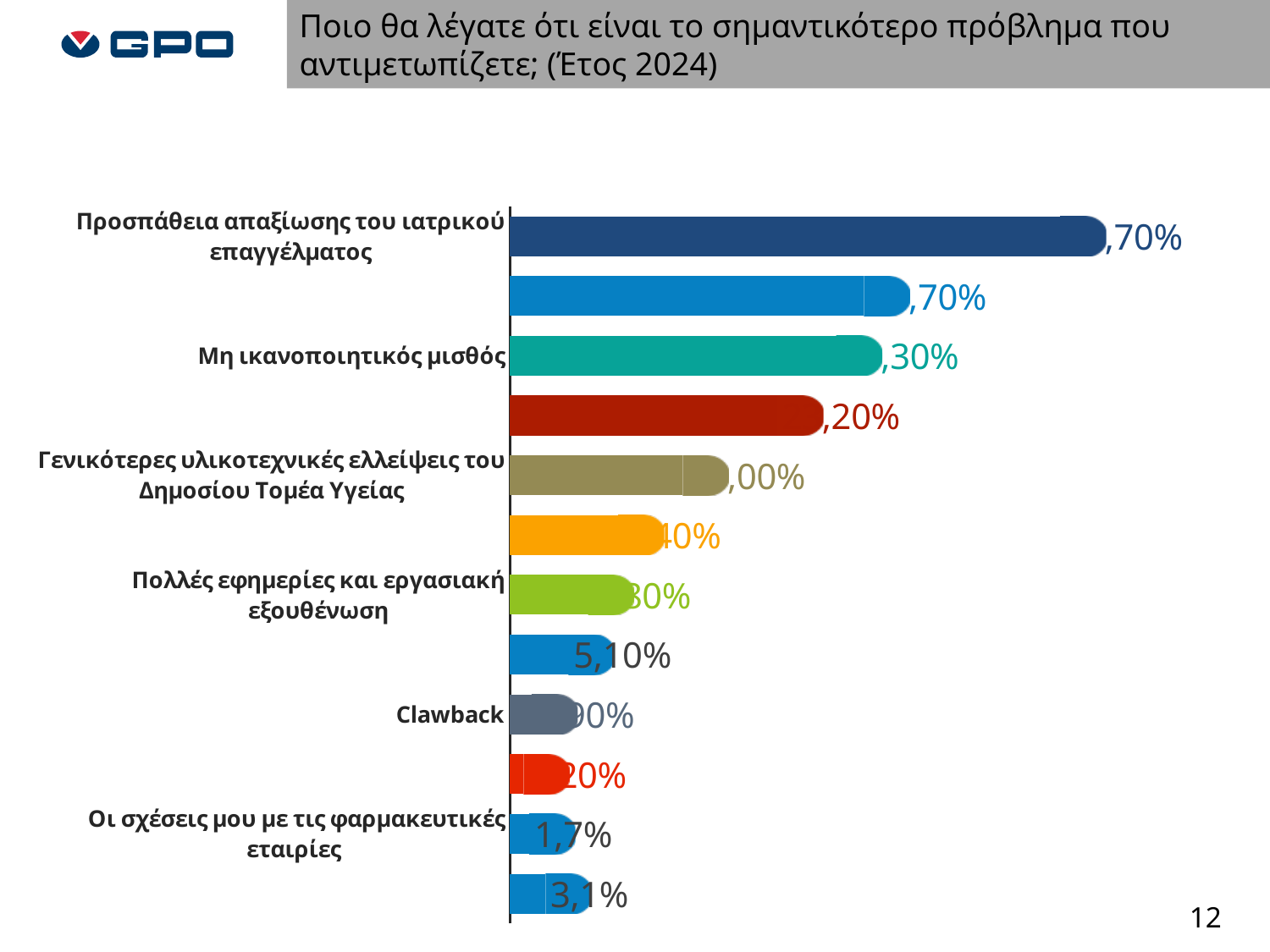
Which is larger, the value for 'Μη ικανοποιητικός μισθός' or the value for 'Clawback'? Μη ικανοποιητικός μισθός How many bars does the chart contain? 12 What type of chart is shown on the slide? Bar chart Which is larger, the value for 'Γενικότερες υλικοτεχνικές ελλείψεις του Δημοσίου Τομέα Υγείας' or the value for 'Πολλές εφημερίες και εργασιακή εξουθένωση'? Γενικότερες υλικοτεχνικές ελλείψεις του Δημοσίου Τομέα Υγείας Do the bar values increase or decrease going from the top of the chart to the bottom? Decrease What is the title of the slide containing the chart? Ποιο θα λέγατε ότι είναι το σημαντικότερο πρόβλημα που αντιμετωπίζετε; (Έτος 2024) Which is larger, the value for 'Προσπάθεια απαξίωσης του ιατρικού επαγγέλματος' or the value for 'Μη ικανοποιητικός μισθός'? Προσπάθεια απαξίωσης του ιατρικού επαγγέλματος What colour is the longest bar in the chart? Dark blue What is the value shown for 'Οι σχέσεις μου με τις φαρμακευτικές εταιρίες'? 1,7% Which category has the highest value in the chart? Προσπάθεια απαξίωσης του ιατρικού επαγγέλματος